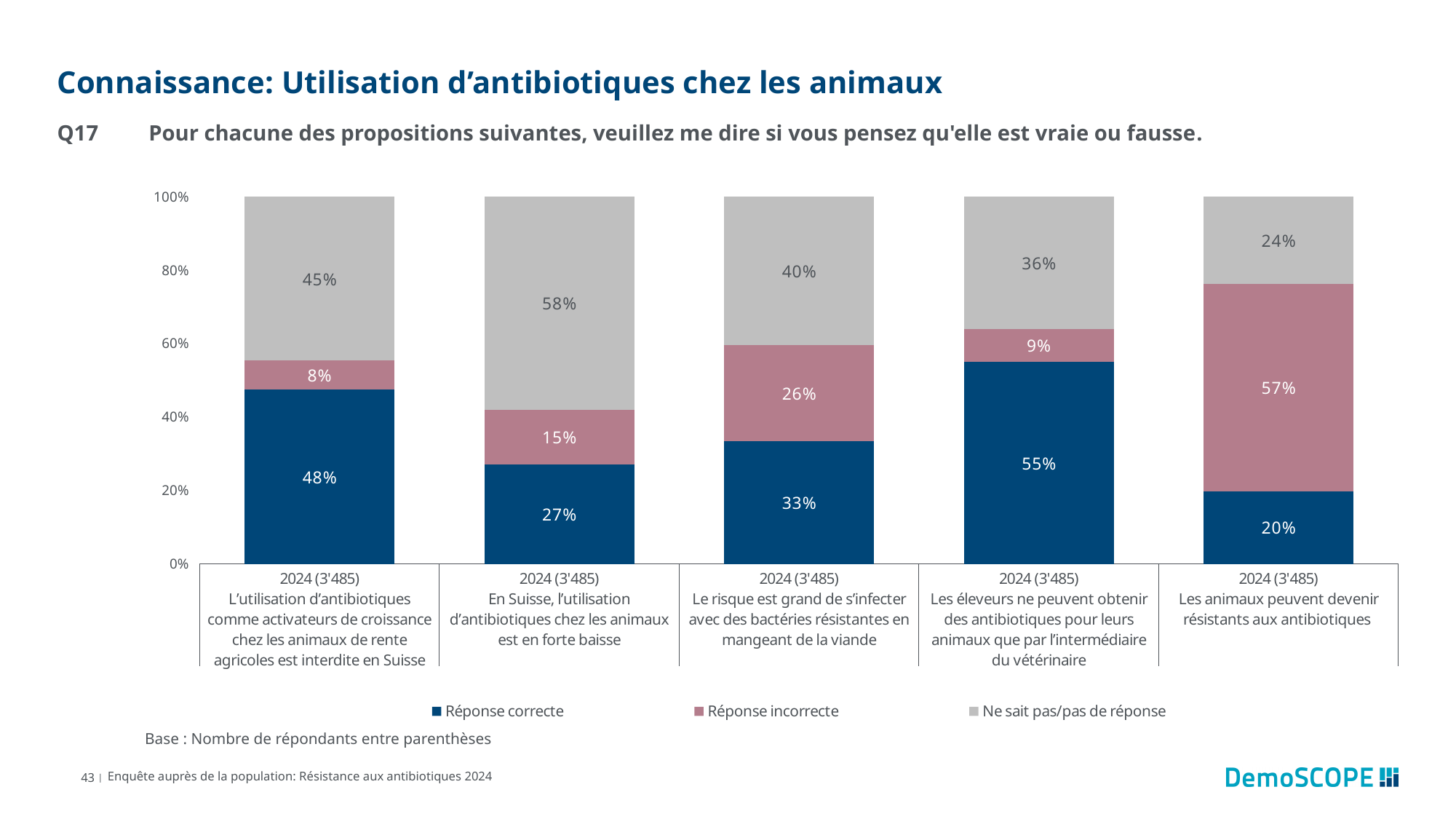
How many statements (bars) are shown in the chart? 5 What is the "Ne sait pas/pas de réponse" share for the statement "En Suisse, l'utilisation d'antibiotiques chez les animaux est en forte baisse"? 58% What type of chart is shown on the slide? Stacked bar chart What is the difference in the "Réponse correcte" share between the statement about veterinarians (55%) and the statement about growth promoters being banned in Switzerland (48%)? 7 percentage points Is the "Ne sait pas/pas de réponse" share larger for the statement about antibiotic use being in sharp decline or for the statement about the risk of infection from eating meat? En Suisse, l'utilisation d'antibiotiques chez les animaux est en forte baisse What percentage of respondents gave the correct answer (Réponse correcte) for the statement "Les animaux peuvent devenir résistants aux antibiotiques"? 20% What is the number of respondents shown in parentheses for each bar? 3'485 Which statement has the highest share of correct answers (Réponse correcte)? Les éleveurs ne peuvent obtenir des antibiotiques pour leurs animaux que par l'intermédiaire du vétérinaire Which statement has the highest share of incorrect answers (Réponse incorrecte)? Les animaux peuvent devenir résistants aux antibiotiques What is the "Réponse incorrecte" share for the statement "Le risque est grand de s'infecter avec des bactéries résistantes en mangeant de la viande"? 26% How many series does the legend list? 3 Which statement has the lowest share of correct answers (Réponse correcte)? Les animaux peuvent devenir résistants aux antibiotiques